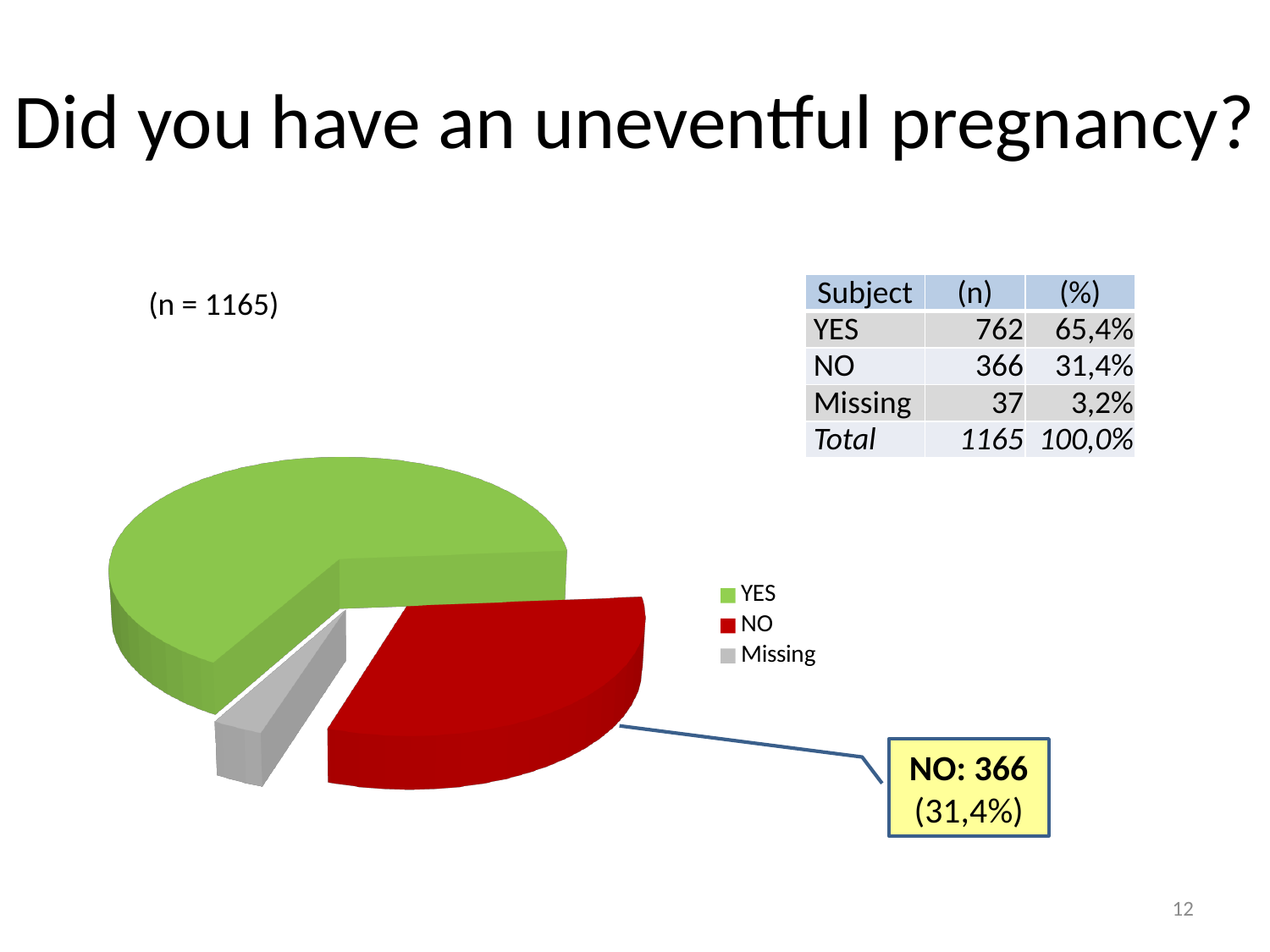
What percentage share does the NO slice represent, as shown in the callout? 31,4% How many entries does the legend of the pie chart list? 3 Which category has the largest slice in the pie chart? YES What is the count (n) for the NO slice, as shown in the callout on the chart? 366 What colour is the YES slice in the pie chart? green Is the YES slice larger or smaller than the NO slice? larger How many slices does the pie chart have? 3 According to the table on the slide, what is the count (n) for YES? 762 What kind of chart is shown on the slide? pie chart Which category has the smallest slice in the pie chart? Missing According to the table on the slide, what percentage does the Missing slice represent? 3,2% What is the difference in count (n) between YES and NO, using the values in the table? 396